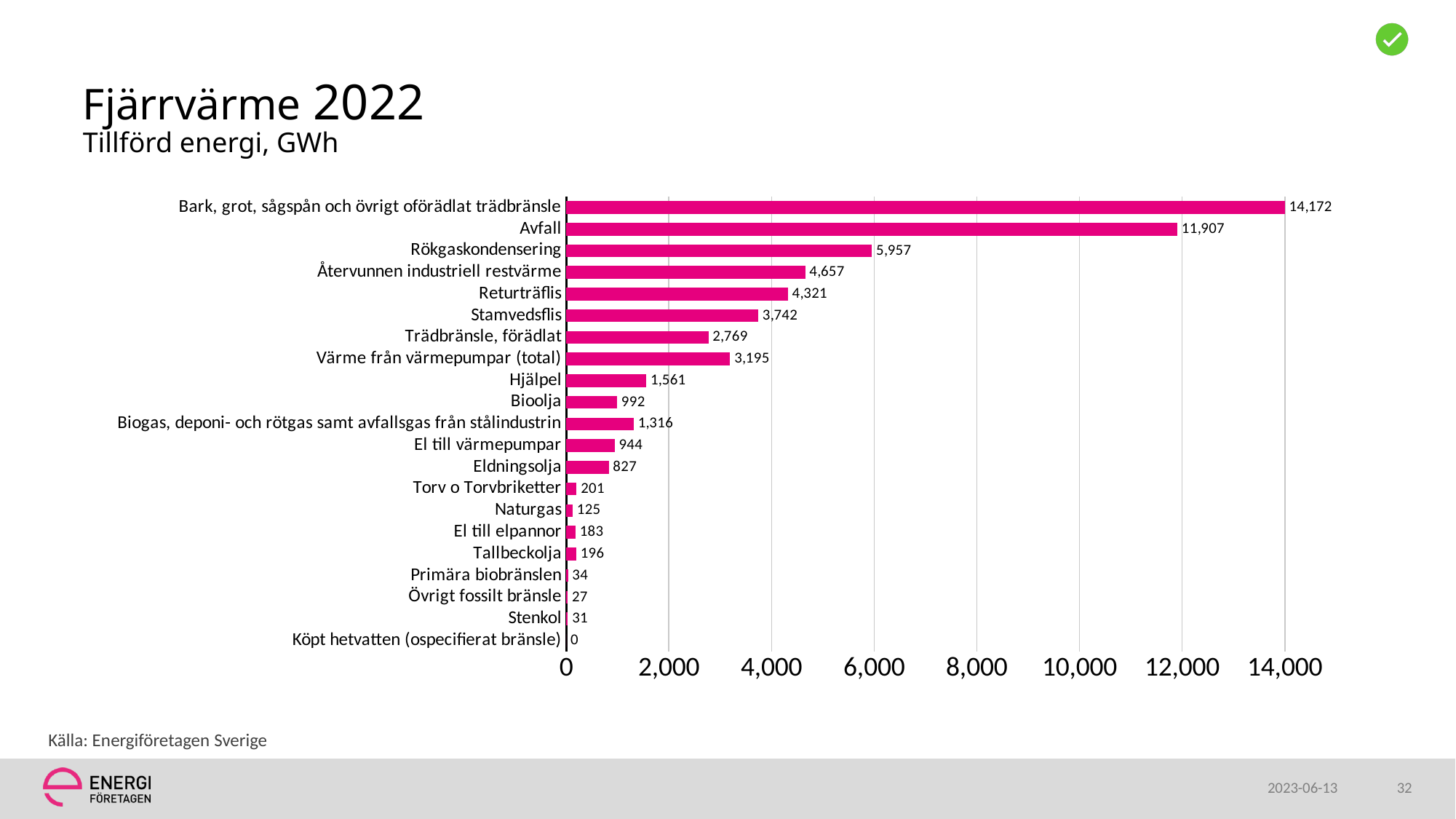
What kind of chart is shown on the slide? bar chart How many categories are shown in the chart? 21 Which is larger, the value for Bioolja or the value for El till värmepumpar? Bioolja What is the title of the chart? Fjärrvärme 2022 Is the value for Återvunnen industriell restvärme greater or less than 4,000? greater What is the value for Eldningsolja? 827 Which category has the highest value? Bark, grot, sågspån och övrigt oförädlat trädbränsle What is the value for Rökgaskondensering? 5,957 What unit is the energy measured in, according to the subtitle? GWh Which category has the lowest value? Köpt hetvatten (ospecifierat bränsle) What is the difference between the values for Bark, grot, sågspån och övrigt oförädlat trädbränsle and Avfall? 2,265 What is the value for Avfall? 11,907